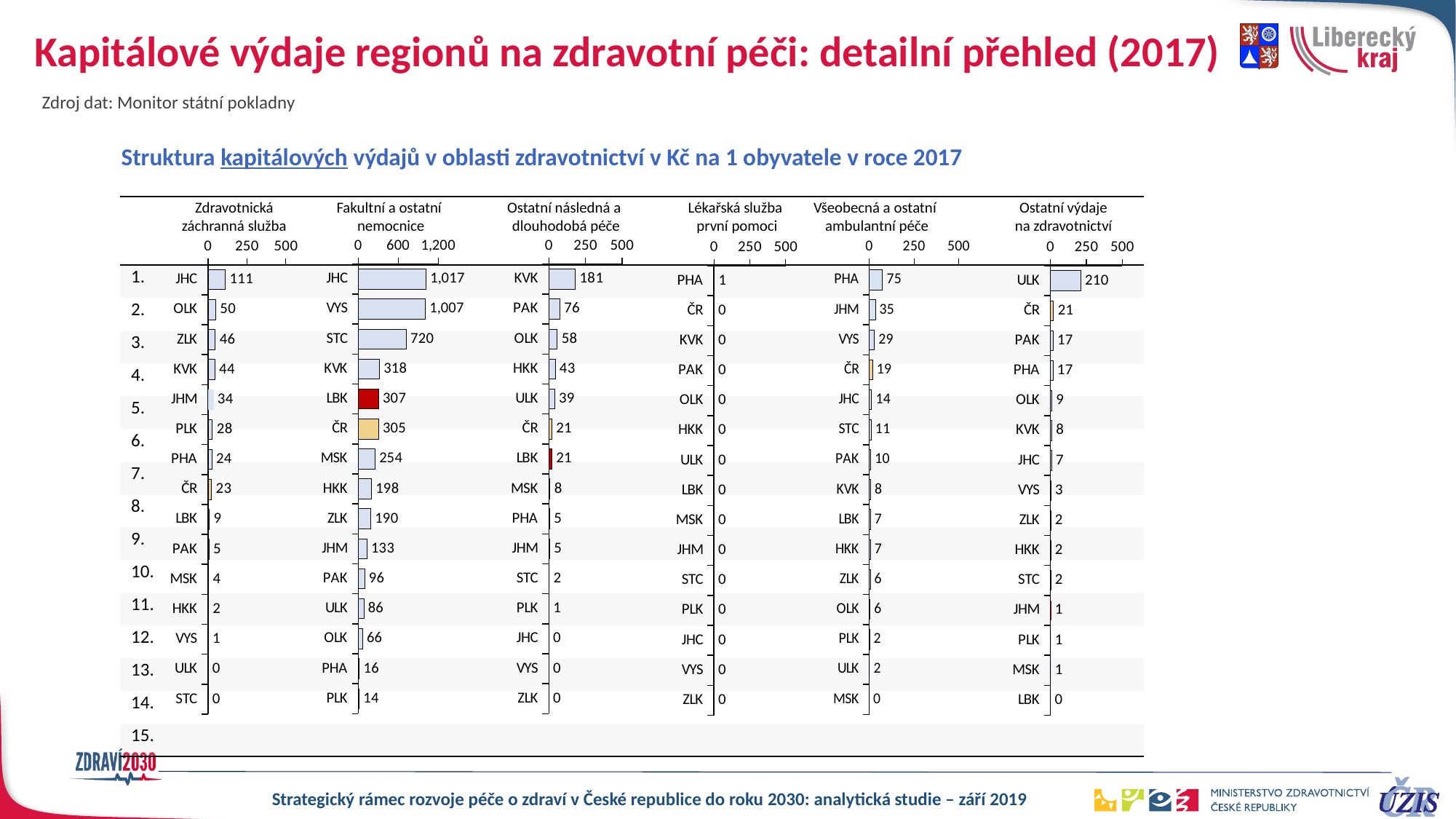
In the 'Zdravotnická záchranná služba' chart, what is the value for JHC? 111 In the 'Ostatní následná a dlouhodobá péče' chart, what is the value for KVK? 181 In the 'Fakultní a ostatní nemocnice' chart, is the value for STC greater or less than 600? greater What type of chart is used for 'Všeobecná a ostatní ambulantní péče'? bar chart In the 'Lékařská služba první pomoci' chart, what is the value for PHA? 1 In the 'Ostatní výdaje na zdravotnictví' chart, which region has the highest value? ULK In the 'Zdravotnická záchranná služba' chart, which is larger, the value for OLK or the value for LBK? OLK How many bars (rows) does the 'Ostatní výdaje na zdravotnictví' chart contain? 15 In the 'Všeobecná a ostatní ambulantní péče' chart, what is the difference between the values for PHA and JHM? 40 In the 'Fakultní a ostatní nemocnice' chart, what is the difference between the values for JHC and VYS? 10 In the 'Všeobecná a ostatní ambulantní péče' chart, which region has the lowest value? MSK In the 'Fakultní a ostatní nemocnice' chart, what is the value for LBK? 307